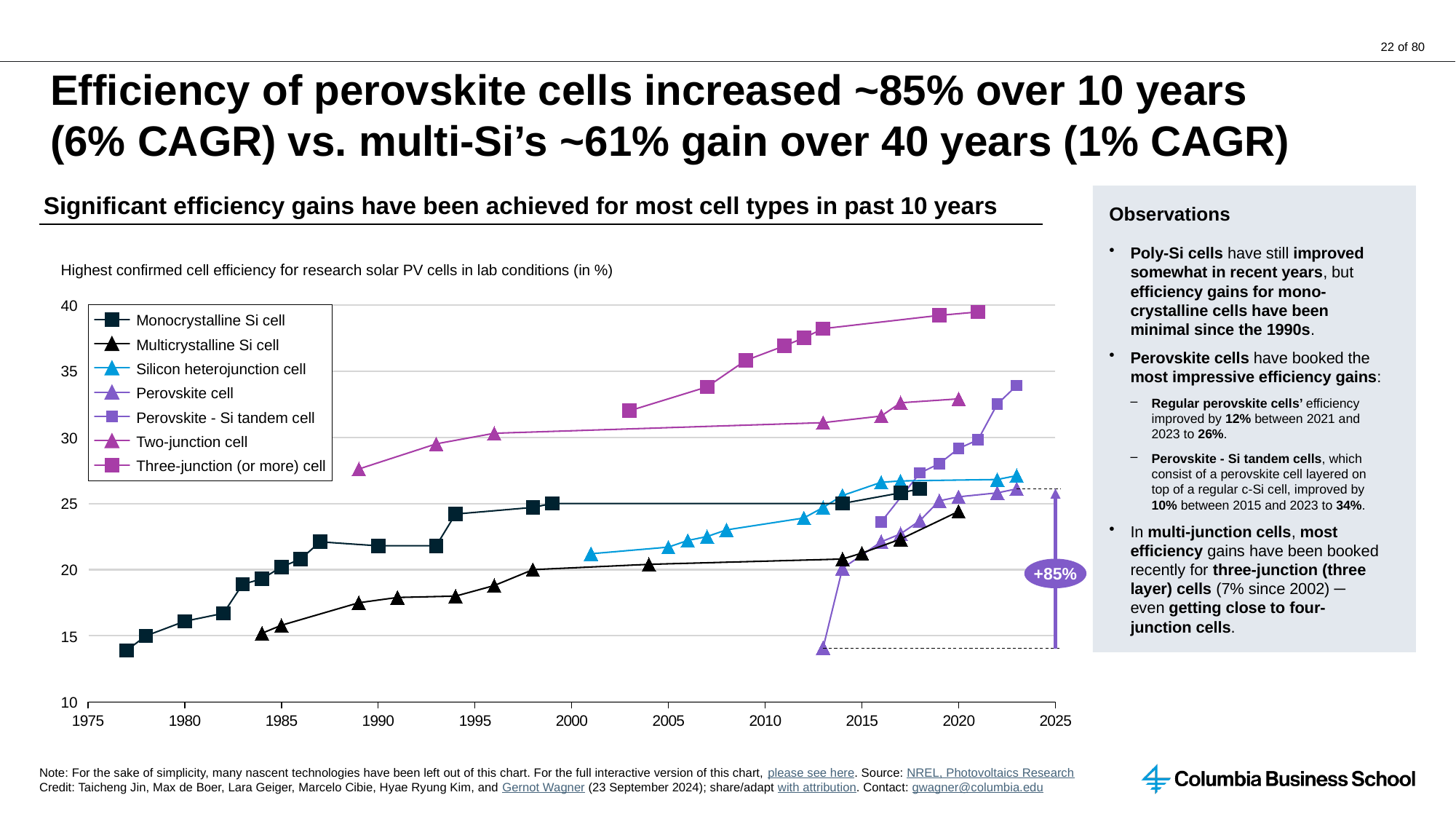
Which cell type reaches the highest efficiency on the chart? Three-junction (or more) cell In 2023, which has the higher efficiency: the Perovskite - Si tandem cell or the Silicon heterojunction cell? Perovskite - Si tandem cell Is the efficiency of the Perovskite - Si tandem cell in 2023 greater or less than 30? greater In 2020, which has the higher efficiency: the Three-junction (or more) cell or the Two-junction cell? Three-junction (or more) cell What kind of chart is shown on the slide? Line chart Is the efficiency of the Two-junction cell in 1989 greater or less than 30? less Does the efficiency of the Monocrystalline Si cell rise or fall from 1977 to 2018? Rise Is the efficiency of the Three-junction (or more) cell in 2021 greater or less than 35? greater What is the subtitle describing the chart's measure? Highest confirmed cell efficiency for research solar PV cells in lab conditions (in %) How many series does the chart legend list? 7 What percentage gain is shown by the annotation arrow on the right of the chart? +85%